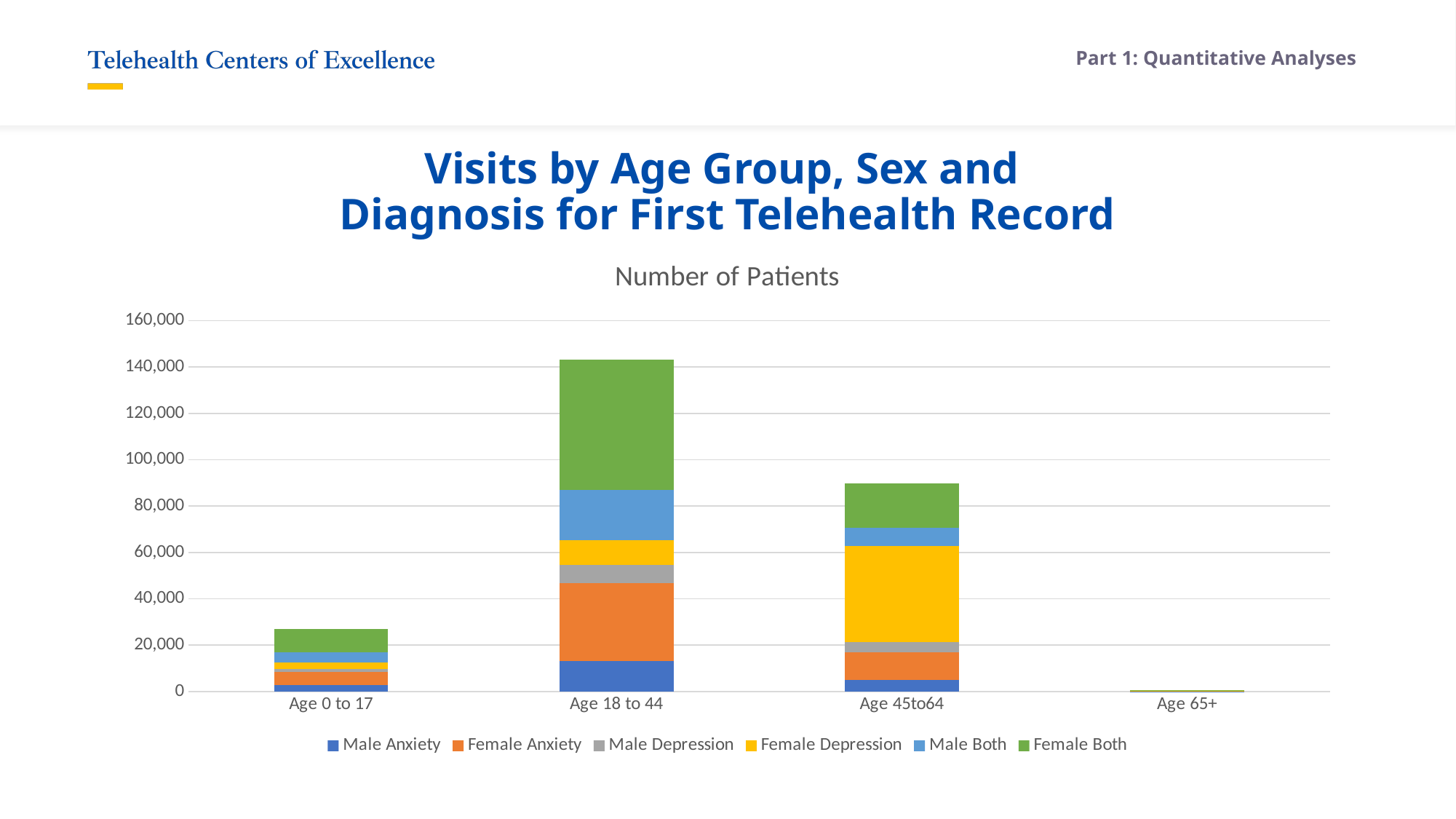
Which stacked bar is taller, Age 45to64 or Age 0 to 17? Age 45to64 Is the total for Age 65+ greater or less than 20,000? less Is the total for Age 45to64 greater or less than 100,000? less Which age group has the tallest stacked bar? Age 18 to 44 Which age group has the shortest stacked bar? Age 65+ What is the title shown directly above the chart's plot area? Number of Patients How many age groups are shown on the x axis? 4 What kind of chart is shown on the slide? Stacked bar chart Is the total for Age 0 to 17 greater or less than 20,000? greater How many series does the legend list? 6 Which series is shown in yellow in the legend? Female Depression